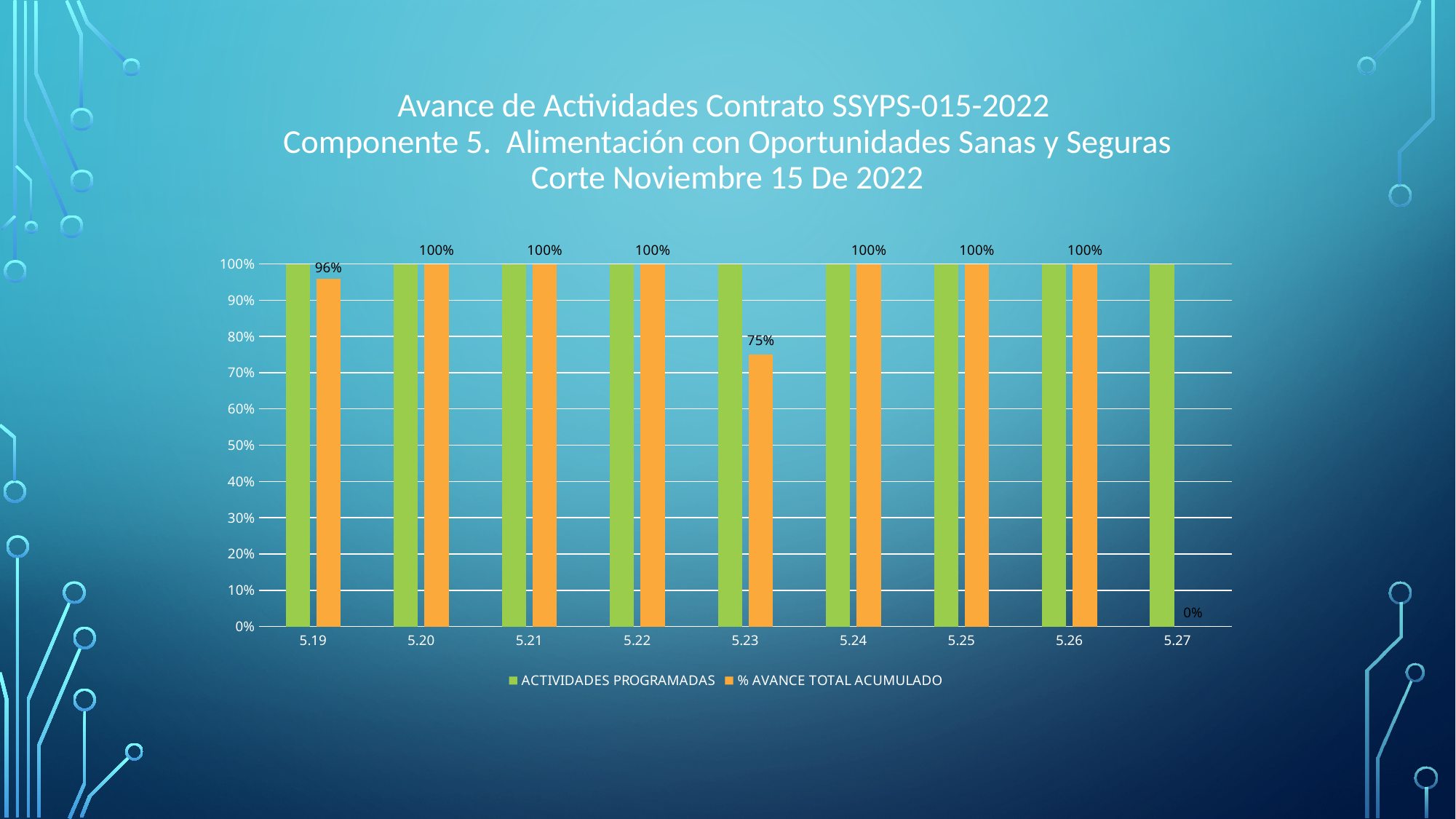
What is the % AVANCE TOTAL ACUMULADO value for category 5.27? 0% How many categories are shown on the x axis of the chart? 9 How many series does the chart legend list? 2 What kind of chart is shown on the slide? Bar chart What is the % AVANCE TOTAL ACUMULADO value for category 5.23? 75% What is the % AVANCE TOTAL ACUMULADO value for category 5.19? 96% What is the % AVANCE TOTAL ACUMULADO value for category 5.24? 100% Which colour represents the ACTIVIDADES PROGRAMADAS series in the chart? Green Is the % AVANCE TOTAL ACUMULADO value for 5.23 greater or less than 80%? less Which category has the lowest % AVANCE TOTAL ACUMULADO value? 5.27 Which is larger, the % AVANCE TOTAL ACUMULADO value for 5.19 or for 5.23? 5.19 What is the difference between the % AVANCE TOTAL ACUMULADO values for 5.19 and 5.23? 21%